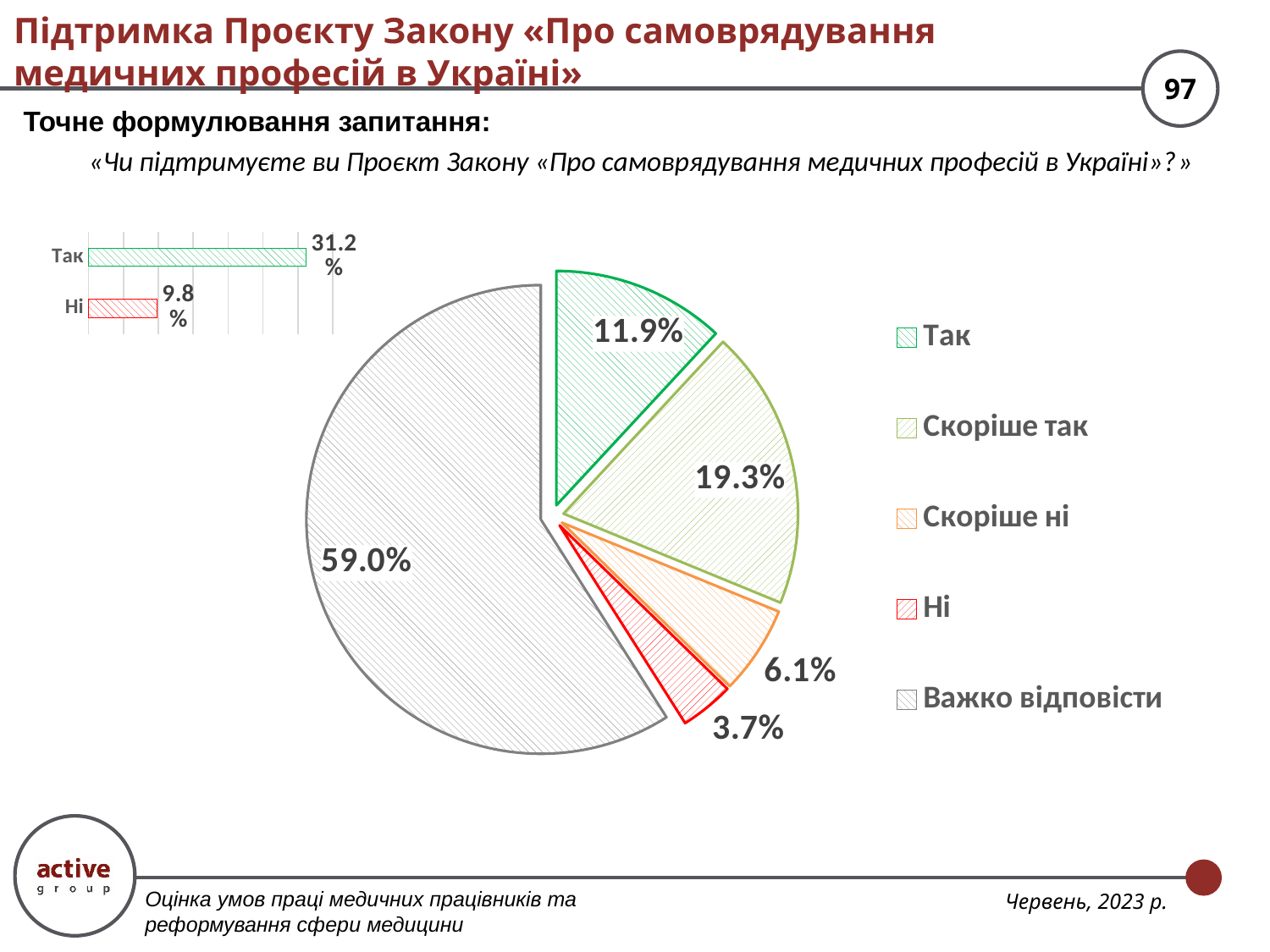
How many categories does the pie chart's legend list? 5 In the pie chart, which is larger: «Скоріше ні» or «Ні»? Скоріше ні In the pie chart, which category has the largest slice? Важко відповісти In the small bar chart at the top left, what is the difference between «Так» and «Ні»? 21.4% What type of chart is the small chart at the top left of the slide? Bar chart In the small bar chart at the top left, what is the value for «Так»? 31.2% In the pie chart, what is the difference between the «Скоріше так» and «Так» slices? 7.4% In the pie chart, which category has the smallest slice? Ні In the pie chart, what share is labelled for «Скоріше так»? 19.3% In the small bar chart at the top left, what is the value for «Ні»? 9.8% In the pie chart, what share is labelled for «Важко відповісти»? 59.0% In the pie chart, what share is labelled for «Ні»? 3.7%